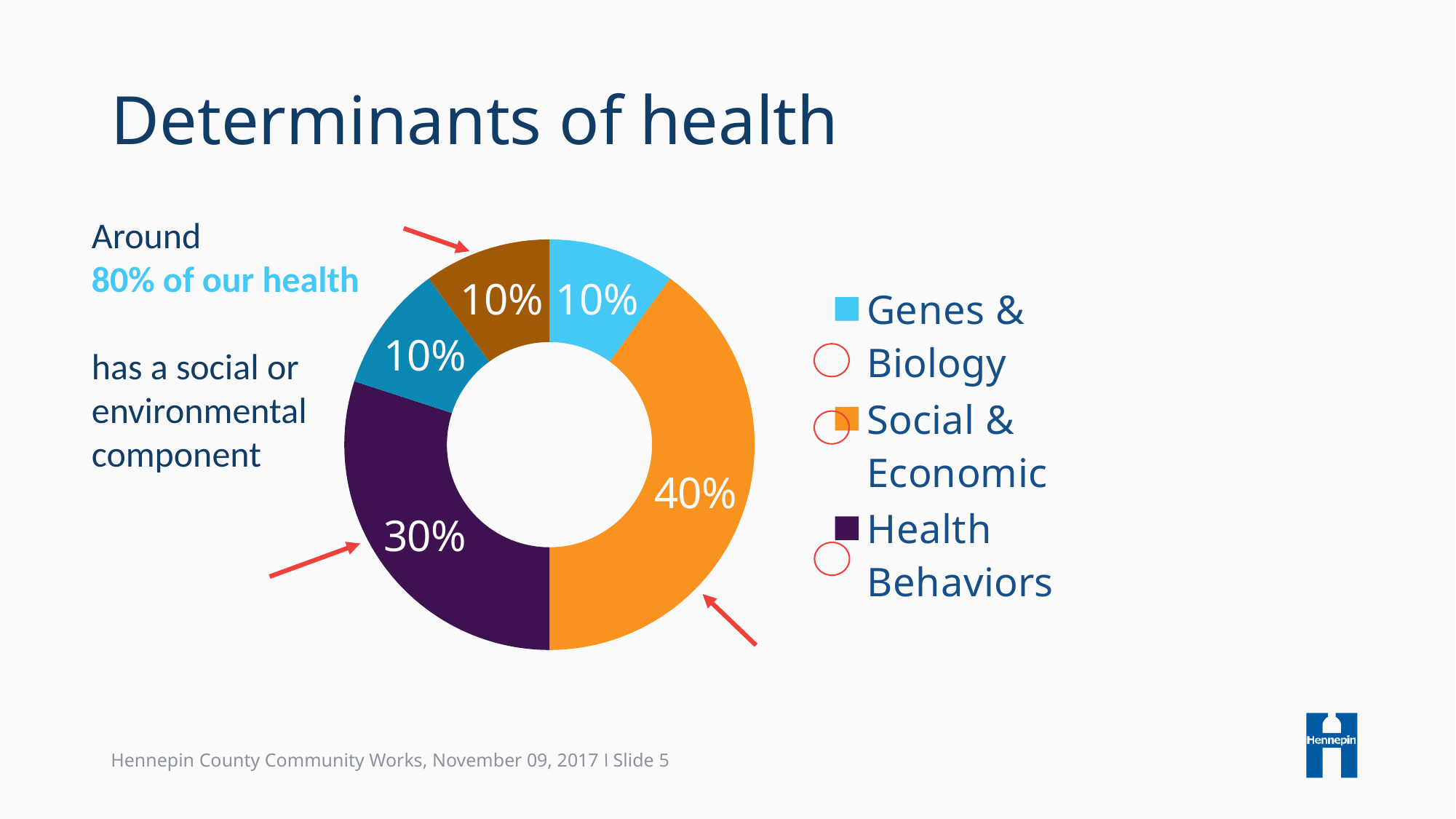
How many slices does the chart have? 5 How many entries does the legend list? 3 What is the difference between the Social & Economic slice and the Health Behaviors slice? 10% What is the difference between the Health Behaviors slice and the Genes & Biology slice? 20% What kind of chart is shown on the slide? Doughnut chart What percentage does the Genes & Biology slice represent? 10% Which is larger, the Social & Economic slice or the Genes & Biology slice? Social & Economic What percentage does the Health Behaviors slice represent? 30% Which category has the largest slice of the chart? Social & Economic What colour is the Health Behaviors slice? Dark purple What is the title of the slide containing the chart? Determinants of health What percentage does the Social & Economic slice represent? 40%